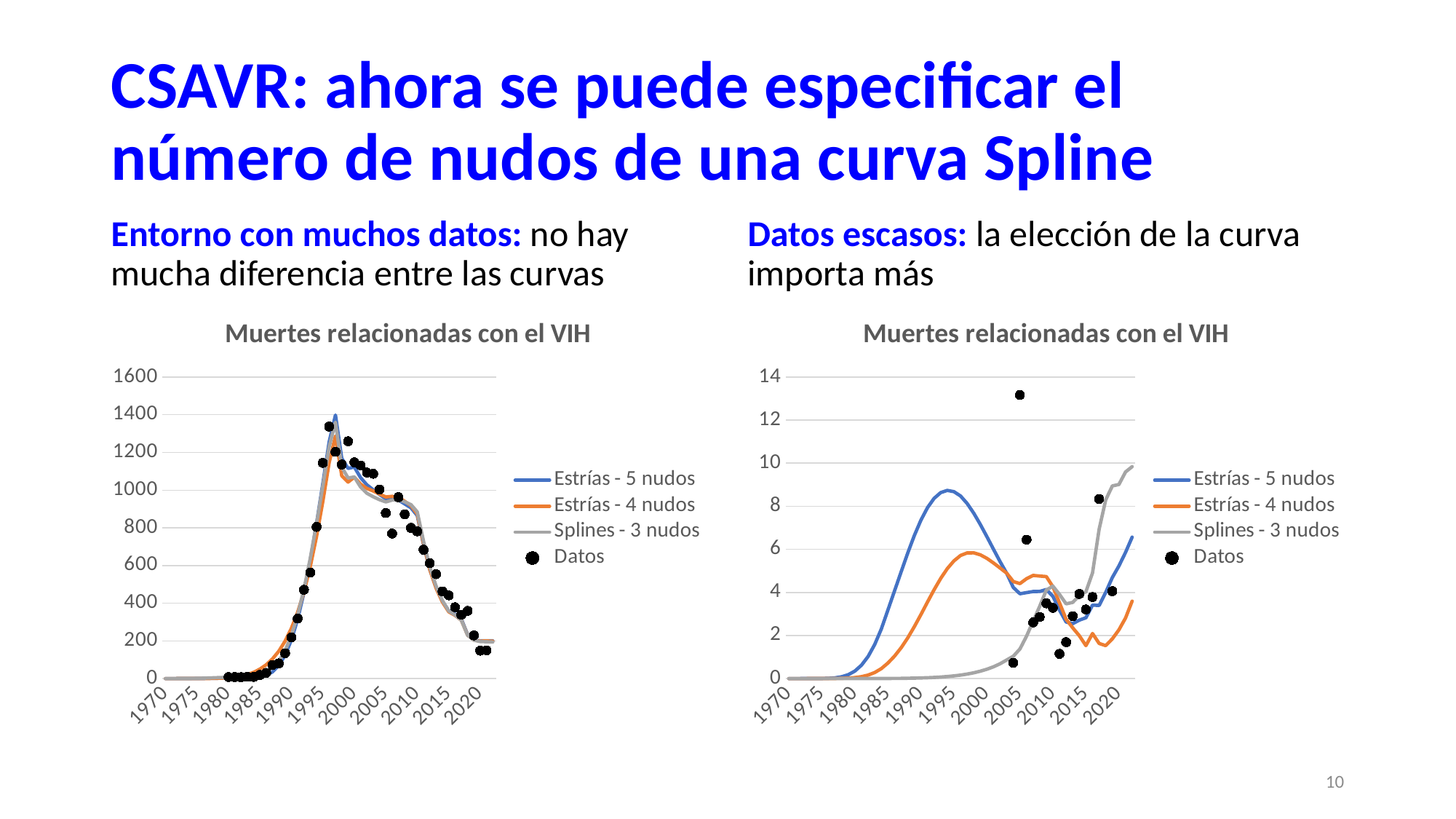
What is the title of the right chart? Muertes relacionadas con el VIH In the left chart, is the peak value of the 'Estrías - 5 nudos' line greater or less than 1200? greater In the left chart, do the curves rise or fall between 2005 and 2020? fall In the right chart, is the peak value of the 'Estrías - 5 nudos' line greater or less than 8? greater In the right chart, around 1995, which line is higher: 'Estrías - 5 nudos' or 'Estrías - 4 nudos'? Estrías - 5 nudos What type of chart is the left chart titled 'Muertes relacionadas con el VIH'? line chart In the left chart, do the curves rise or fall between 1985 and 1995? rise In the left chart, are the values of the curves at 2020 greater or less than 400? less How many series does the legend of the right chart list? 4